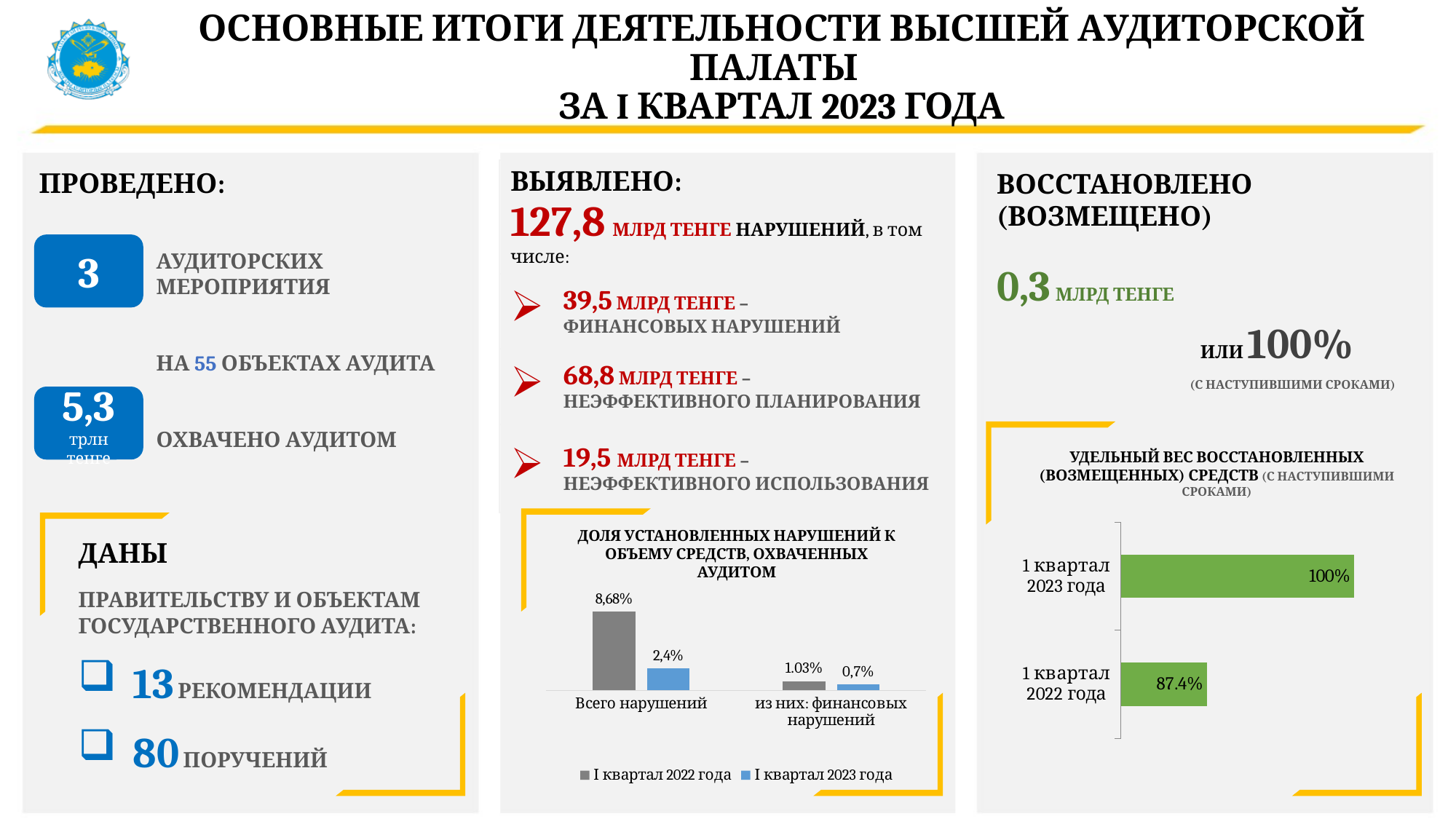
In the chart titled 'ДОЛЯ УСТАНОВЛЕННЫХ НАРУШЕНИЙ К ОБЪЕМУ СРЕДСТВ, ОХВАЧЕННЫХ АУДИТОМ', what is the value for 'из них: финансовых нарушений' in I квартал 2022 года? 1.03% In the chart titled 'ДОЛЯ УСТАНОВЛЕННЫХ НАРУШЕНИЙ К ОБЪЕМУ СРЕДСТВ, ОХВАЧЕННЫХ АУДИТОМ', which series is shown in grey? I квартал 2022 года In the chart titled 'УДЕЛЬНЫЙ ВЕС ВОССТАНОВЛЕННЫХ (ВОЗМЕЩЕННЫХ) СРЕДСТВ', what is the value for 1 квартал 2022 года? 87.4% In the chart titled 'УДЕЛЬНЫЙ ВЕС ВОССТАНОВЛЕННЫХ (ВОЗМЕЩЕННЫХ) СРЕДСТВ', what is the value for 1 квартал 2023 года? 100% What kind of chart is the one titled 'УДЕЛЬНЫЙ ВЕС ВОССТАНОВЛЕННЫХ (ВОЗМЕЩЕННЫХ) СРЕДСТВ'? Bar chart In the chart titled 'ДОЛЯ УСТАНОВЛЕННЫХ НАРУШЕНИЙ К ОБЪЕМУ СРЕДСТВ, ОХВАЧЕННЫХ АУДИТОМ', what is the value for 'Всего нарушений' in I квартал 2023 года? 2,4% In the chart titled 'ДОЛЯ УСТАНОВЛЕННЫХ НАРУШЕНИЙ К ОБЪЕМУ СРЕДСТВ, ОХВАЧЕННЫХ АУДИТОМ', what is the value for 'Всего нарушений' in I квартал 2022 года? 8,68% In the chart titled 'ДОЛЯ УСТАНОВЛЕННЫХ НАРУШЕНИЙ К ОБЪЕМУ СРЕДСТВ, ОХВАЧЕННЫХ АУДИТОМ', what is the value for 'из них: финансовых нарушений' in I квартал 2023 года? 0,7% In the chart titled 'УДЕЛЬНЫЙ ВЕС ВОССТАНОВЛЕННЫХ (ВОЗМЕЩЕННЫХ) СРЕДСТВ', what is the difference between the values for 1 квартал 2023 года and 1 квартал 2022 года? 12.6% In the chart titled 'ДОЛЯ УСТАНОВЛЕННЫХ НАРУШЕНИЙ К ОБЪЕМУ СРЕДСТВ, ОХВАЧЕННЫХ АУДИТОМ', what is the difference between the 'Всего нарушений' values for I квартал 2022 года and I квартал 2023 года? 6,28% In the chart titled 'ДОЛЯ УСТАНОВЛЕННЫХ НАРУШЕНИЙ К ОБЪЕМУ СРЕДСТВ, ОХВАЧЕННЫХ АУДИТОМ', which bar is the highest? Всего нарушений, I квартал 2022 года In the chart titled 'ДОЛЯ УСТАНОВЛЕННЫХ НАРУШЕНИЙ К ОБЪЕМУ СРЕДСТВ, ОХВАЧЕННЫХ АУДИТОМ', how many series does the legend list? 2